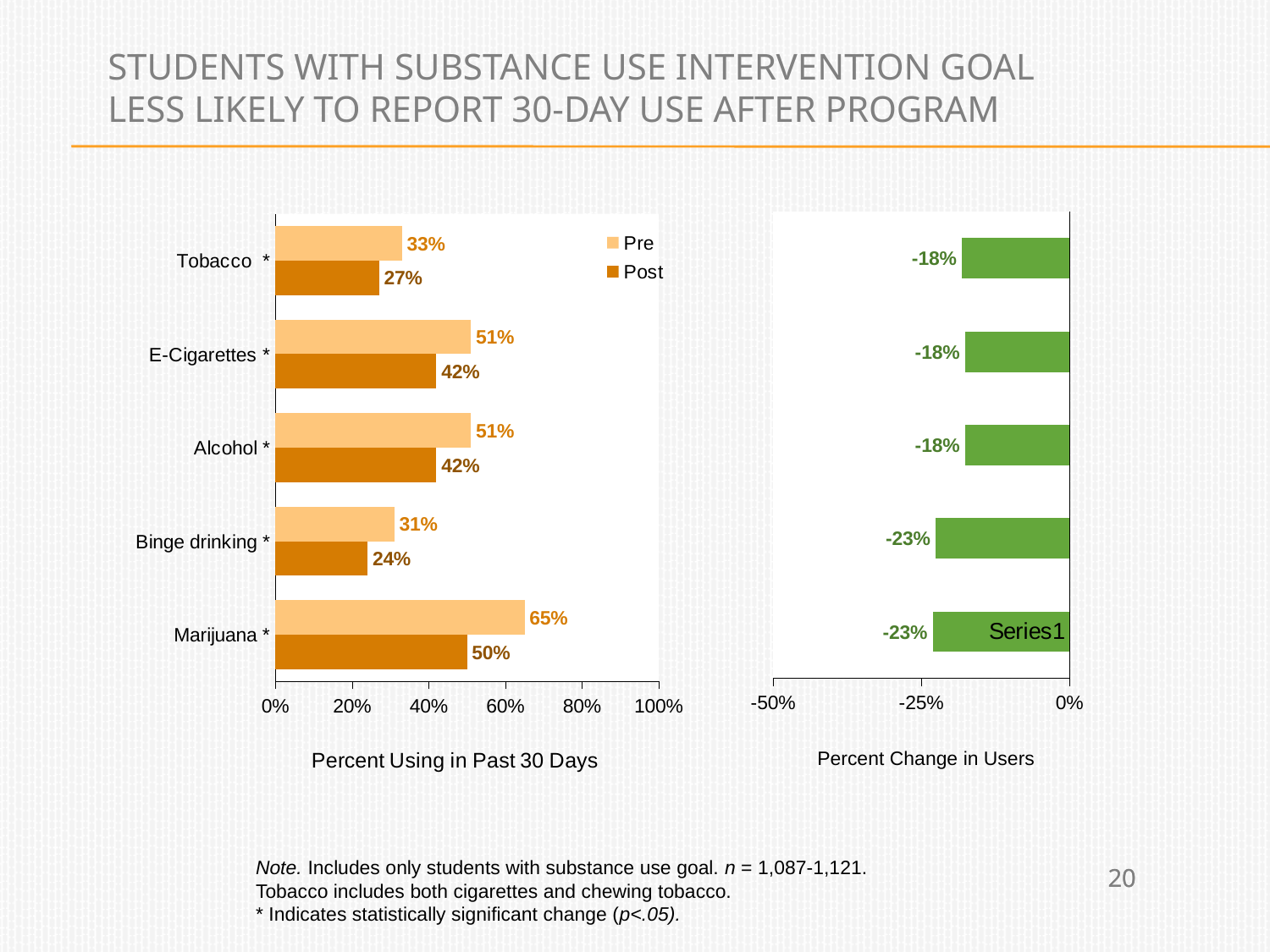
In the left chart (Percent Using in Past 30 Days), what is the difference between the Pre and Post values for E-Cigarettes? 9% In the left chart (Percent Using in Past 30 Days), how many categories are shown? 5 In the left chart (Percent Using in Past 30 Days), what is the Post value for Tobacco? 27% In the left chart (Percent Using in Past 30 Days), what is the Pre value for Marijuana? 65% In the right chart (Percent Change in Users), what is the value for Binge drinking? -23% What kind of chart is the right chart (Percent Change in Users)? Bar chart In the right chart (Percent Change in Users), what is the value for E-Cigarettes? -18% In the left chart (Percent Using in Past 30 Days), how many series does the legend list? 2 In the left chart (Percent Using in Past 30 Days), which category has the lowest Post value? Binge drinking In the left chart (Percent Using in Past 30 Days), which category has the highest Pre value? Marijuana In the left chart (Percent Using in Past 30 Days), what is the difference between the Pre and Post values for Marijuana? 15% In the left chart (Percent Using in Past 30 Days), is the Pre value for Binge drinking larger or the Post value for Alcohol? Post value for Alcohol